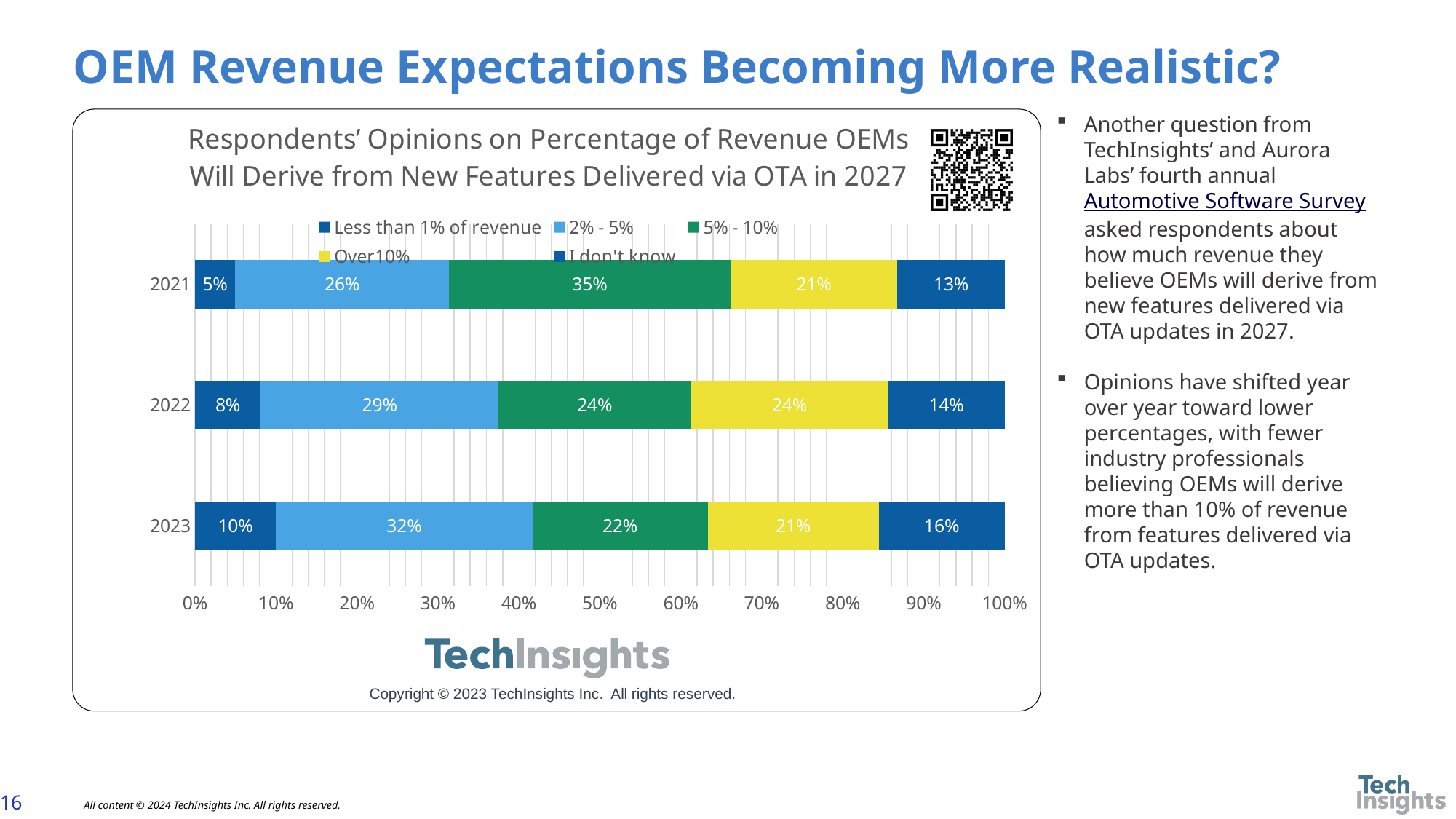
What type of chart is shown on the slide? Stacked bar chart Which year has the lowest value for the 5% - 10% segment? 2023 Is the 'Over10%' segment larger in 2022 or in 2023? 2022 What is the value for 'Less than 1% of revenue' in 2021? 5% What percentage of respondents in 2023 said OEMs will derive 2% - 5% of revenue from new features delivered via OTA? 32% By how many percentage points did the 2% - 5% segment change from 2021 to 2023? 6 percentage points What is the value for the 5% - 10% segment in the 2021 bar? 35% What share of respondents in 2022 answered 'I don't know'? 14% How many series does the legend list? 5 How many years (bars) are shown in the chart? 3 Which year has the highest value for the 'Less than 1% of revenue' segment? 2023 Does the 'Less than 1% of revenue' segment rise or fall from 2021 to 2023? Rise